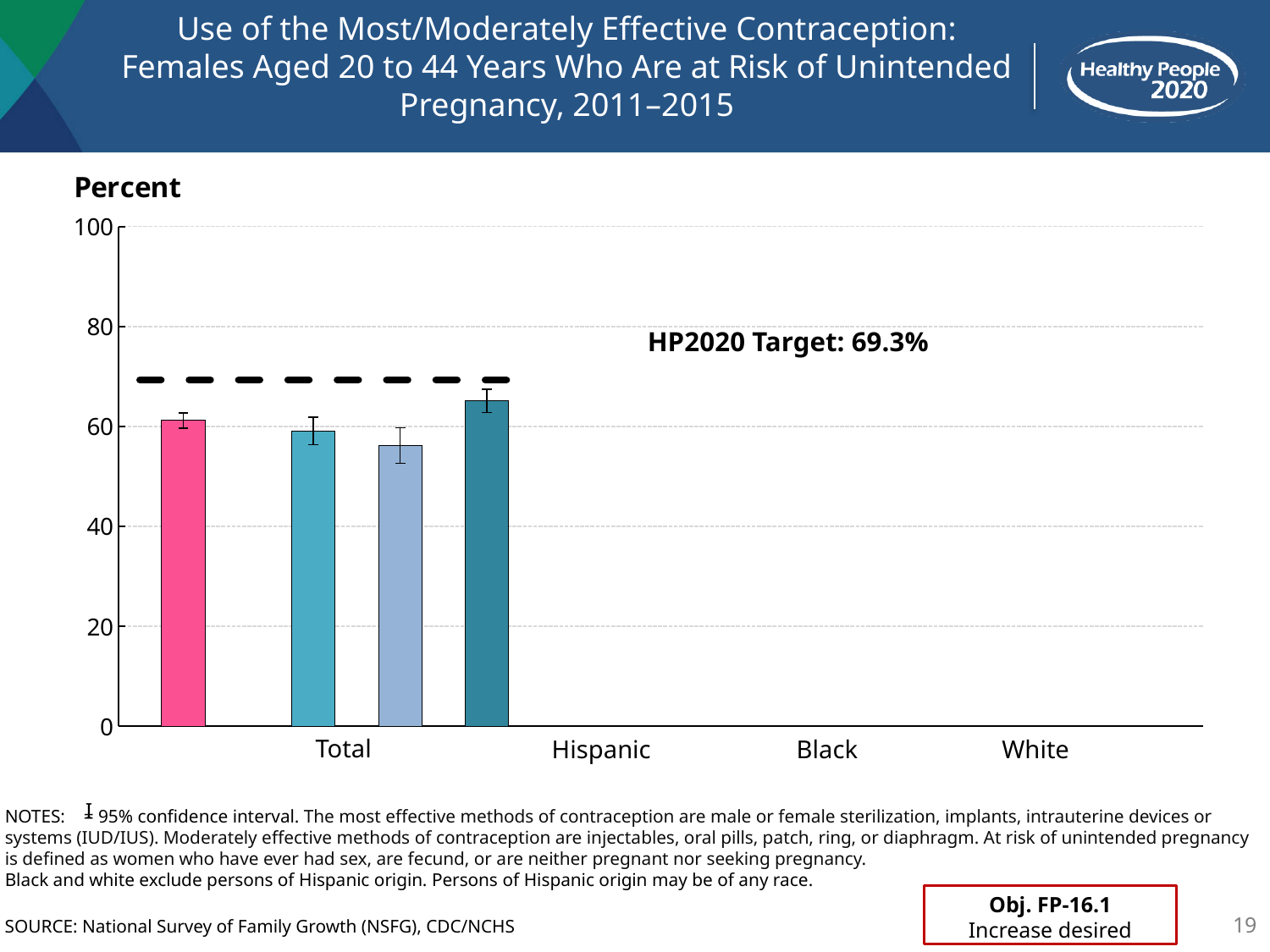
Is the value of the rightmost bar on the chart greater or less than 60? greater Is the value of the third bar from the left on the chart greater or less than 60? less Are all of the bars on the chart greater or less than 40? greater Which category is listed last on the x axis of the chart? White Do any of the bars on the chart reach the HP2020 Target dashed line? No What is the label of the y axis on the chart? Percent Which bar on the chart is the shortest, by position from the left? the third bar How many categories are labeled on the x axis of the chart? 4 What is the HP2020 Target value shown on the chart? 69.3% Which bar on the chart is the tallest: the leftmost bar or the rightmost bar? the rightmost bar What type of chart is shown on the slide? bar chart